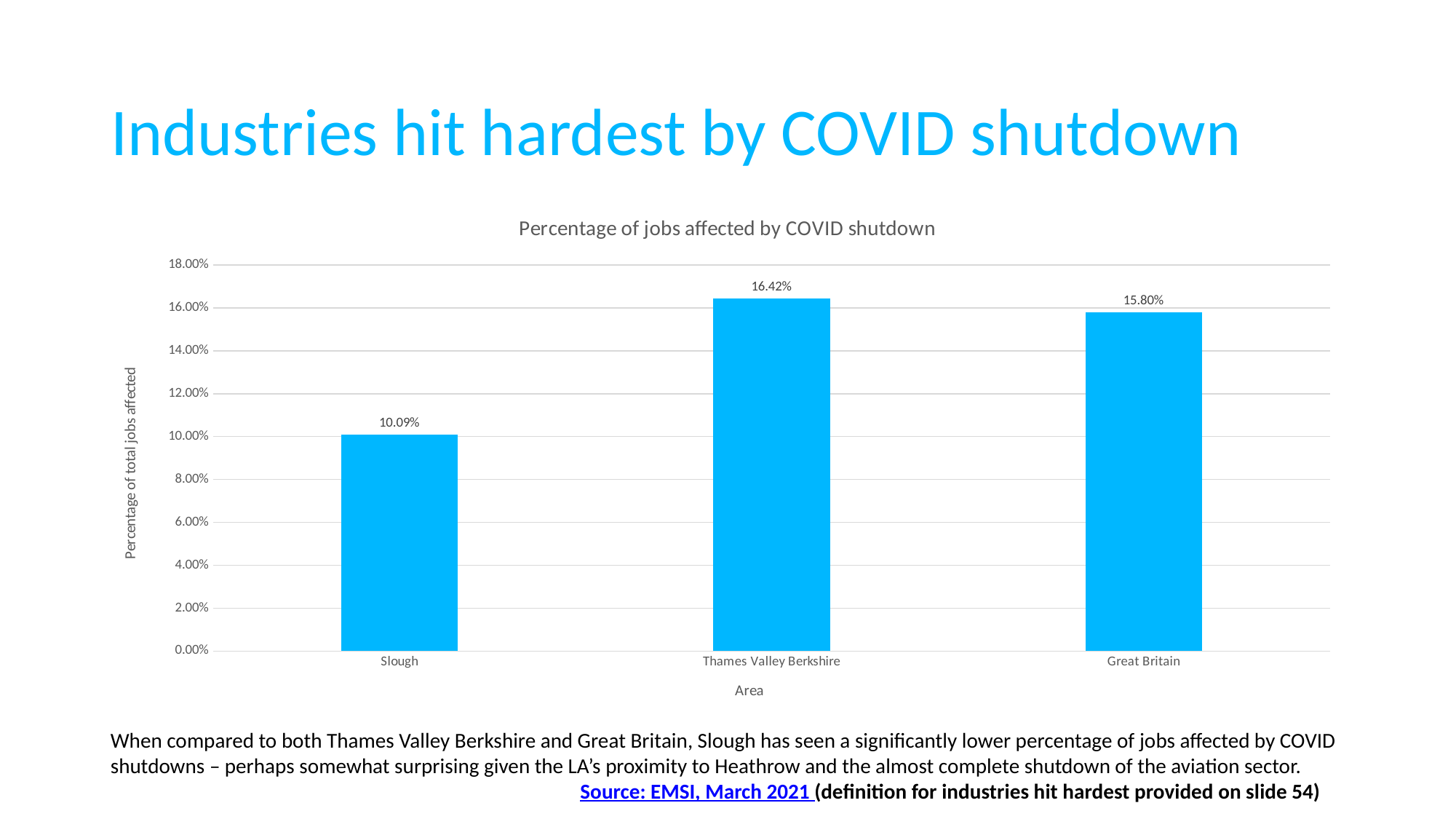
Which has a higher percentage of jobs affected: Great Britain or Slough? Great Britain What is the percentage of jobs affected by COVID shutdown for Great Britain? 15.80% What is the percentage of jobs affected by COVID shutdown for Slough? 10.09% Is the value for Slough greater or less than 12.00%? less What is the percentage of jobs affected by COVID shutdown for Thames Valley Berkshire? 16.42% Which area has the lowest percentage of jobs affected by COVID shutdown? Slough How many areas are shown on the chart? 3 What is the title of the chart? Percentage of jobs affected by COVID shutdown Which area has the highest percentage of jobs affected by COVID shutdown? Thames Valley Berkshire What kind of chart is shown on the slide? Bar chart What is the difference between the percentage for Thames Valley Berkshire and the percentage for Slough? 6.33% What is the difference between the percentage for Great Britain and the percentage for Slough? 5.71%